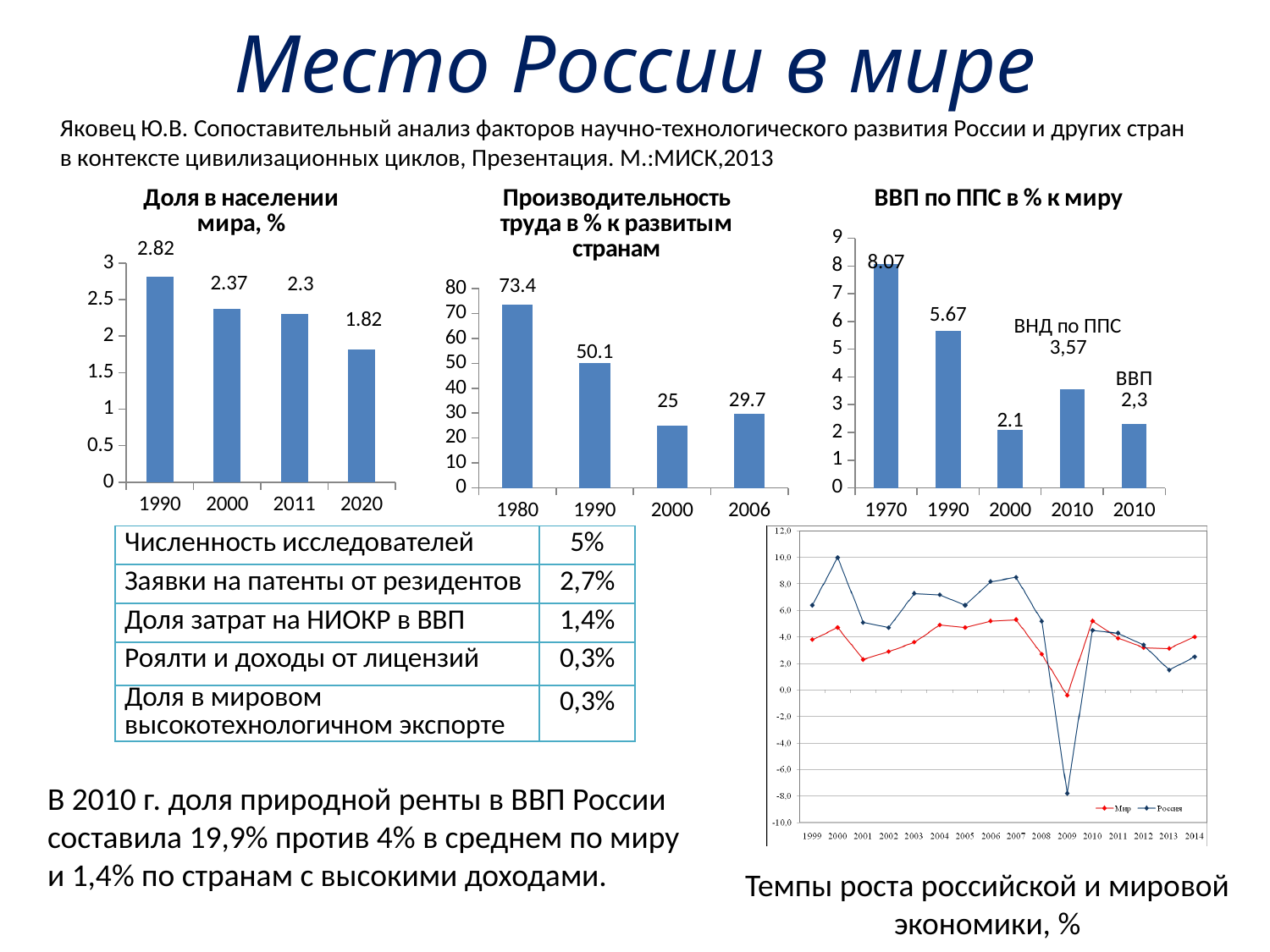
In the chart 'ВВП по ППС в % к миру', what is the value for 1970? 8.07 In the chart 'Производительность труда в % к развитым странам', what is the value for 1980? 73.4 In the chart 'Доля в населении мира, %', which year has the lowest value? 2020 In the chart 'Доля в населении мира, %', what is the value for 1990? 2.82 In the chart 'Темпы роста российской и мировой экономики, %', is the value for Россия in 2009 greater or less than -6.0? less In the chart 'ВВП по ППС в % к миру', which is larger: the value for 1990 or the value for 2000? 1990 In the chart 'ВВП по ППС в % к миру', what is the value labelled 'ВНД по ППС' for 2010? 3,57 How many series does the legend of the chart 'Темпы роста российской и мировой экономики, %' list? 2 In the chart 'Производительность труда в % к развитым странам', how many bars are plotted? 4 In the chart 'Доля в населении мира, %', what is the difference between the values for 1990 and 2020? 1 What kind of chart is 'Темпы роста российской и мировой экономики, %'? line chart In the chart 'Производительность труда в % к развитым странам', which year has the lowest value? 2000